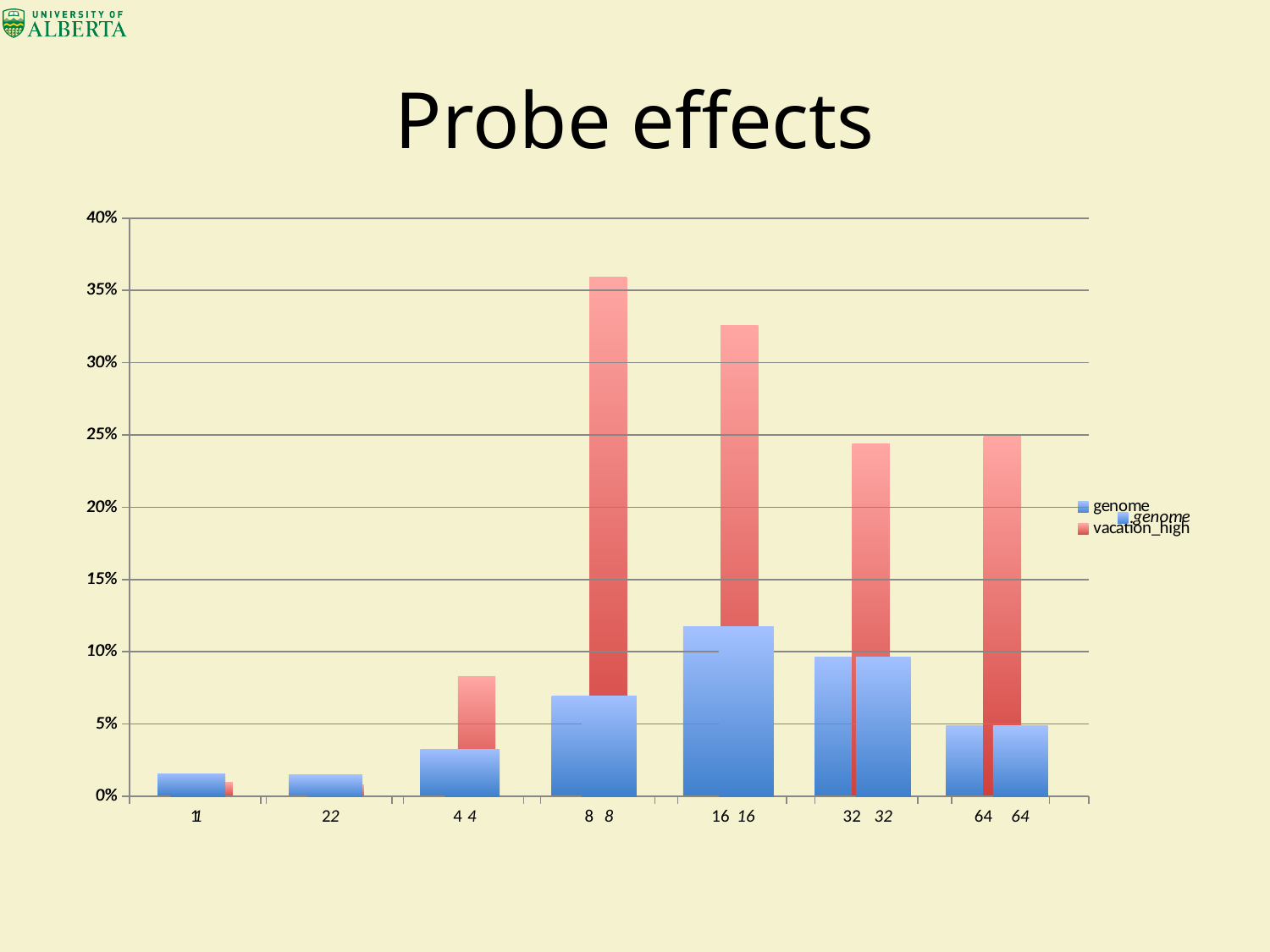
What is the title of the chart? Probe effects For which category is the genome value highest? 16 For category 8, which series has the larger value, genome or vacation_high? vacation_high For category 2, which series has the larger value, genome or vacation_high? genome How many categories are shown on the x axis of the chart? 7 Is the genome value for category 16 greater or less than 10%? greater How many series does the chart's legend list? 2 For which category is the vacation_high value highest? 8 Is the vacation_high value for category 8 greater or less than 35%? greater Is the vacation_high value for category 32 greater or less than 25%? less Which series is shown in red in the chart? vacation_high What kind of chart is shown on the slide? bar chart